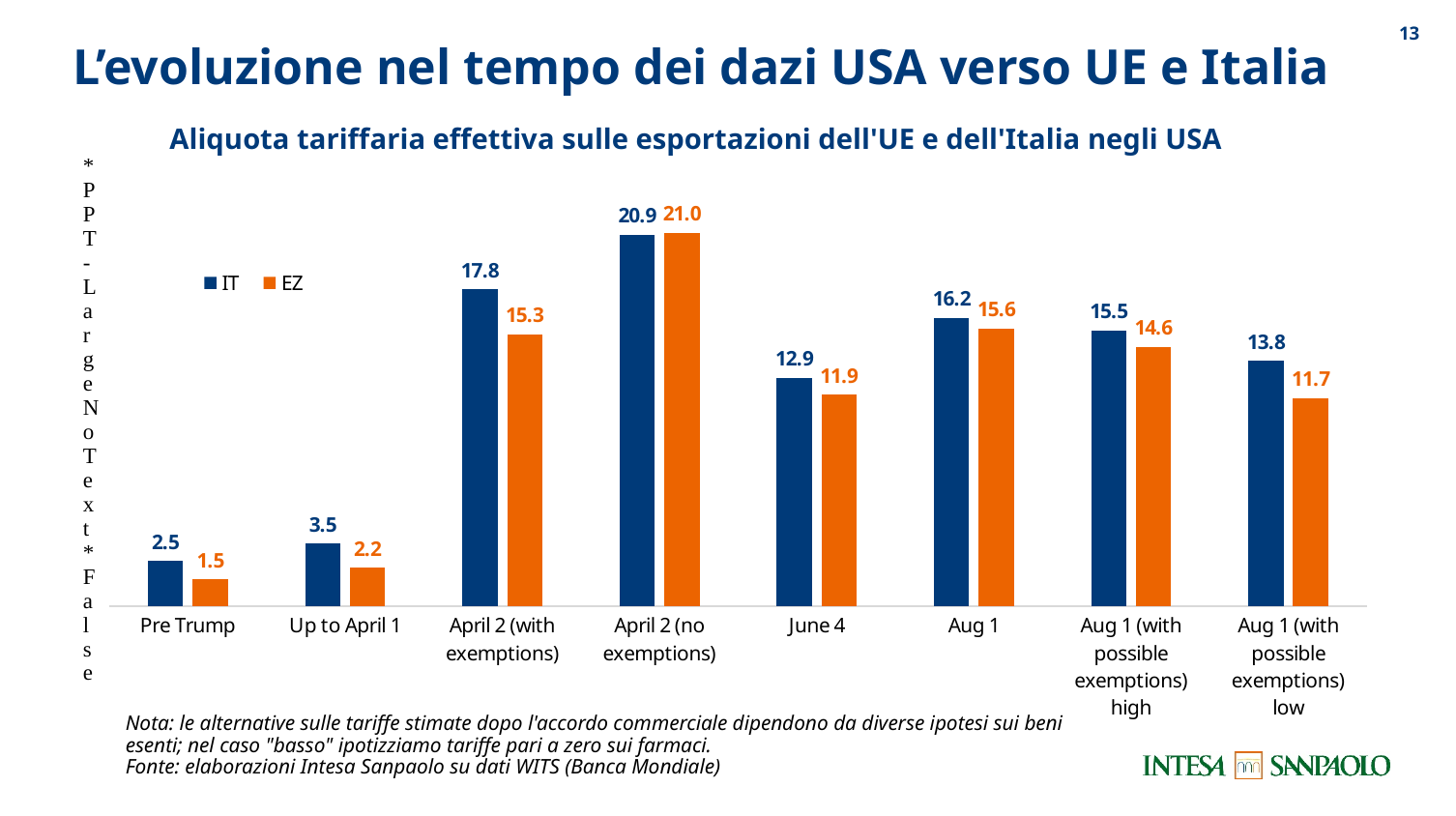
Which is larger for Up to April 1, the IT value or the EZ value? IT How many categories are shown on the x axis? 8 What is the difference between the IT and EZ values for Aug 1 (with possible exemptions) low? 2.1 What is the title of the chart? Aliquota tariffaria effettiva sulle esportazioni dell'UE e dell'Italia negli USA What is the EZ value for June 4? 11.9 Which category has the lowest IT value? Pre Trump Which category has the highest EZ value? April 2 (no exemptions) What is the EZ value for Pre Trump? 1.5 What is the IT value for Aug 1 (with possible exemptions) low? 13.8 What is the IT value for April 2 (with exemptions)? 17.8 What kind of chart is shown on the slide? Bar chart How many series does the legend list? 2